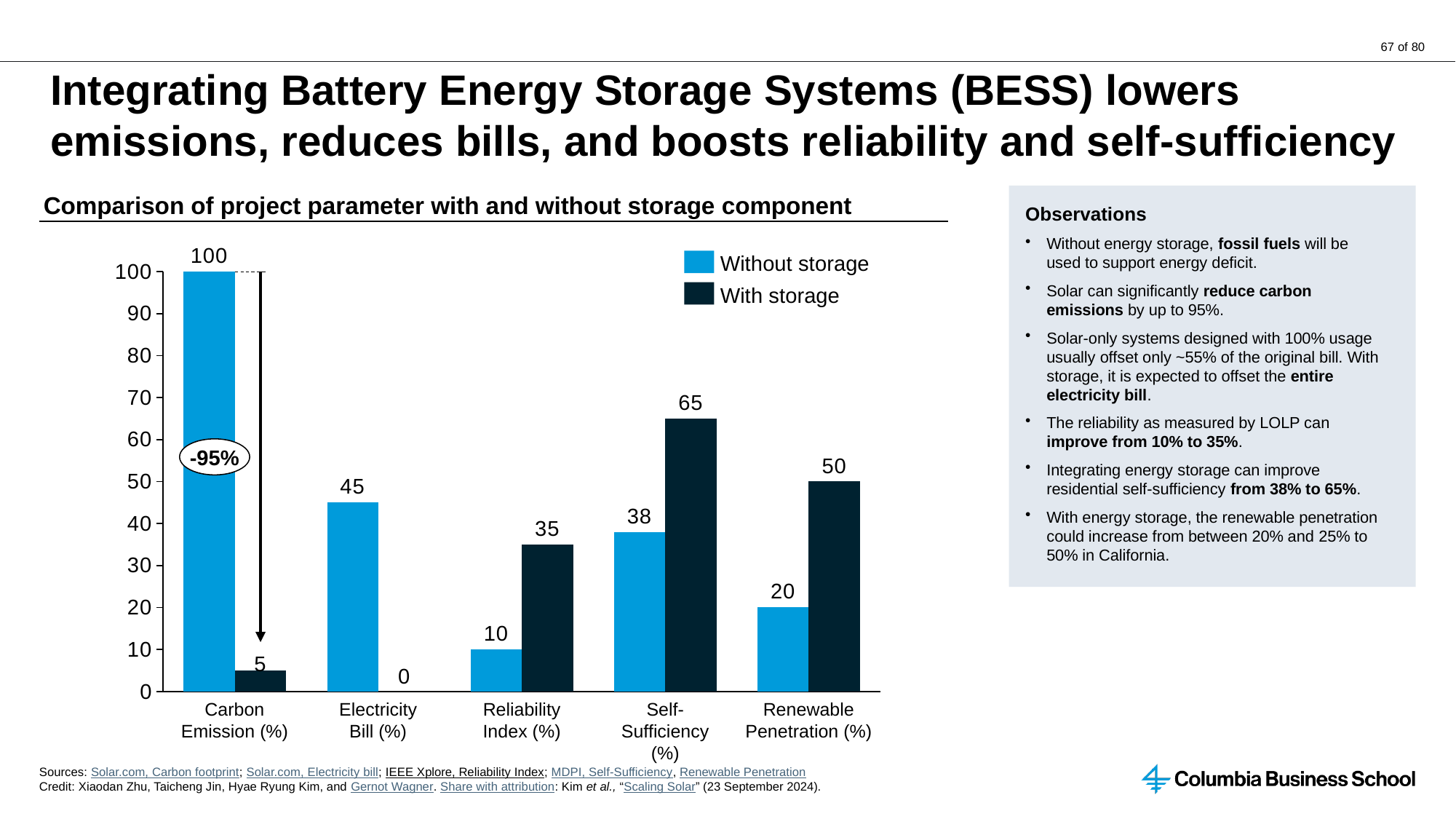
What is the difference between the Without storage and With storage values for Carbon Emission (%)? 95 What percentage change is shown in the oval annotation next to the Carbon Emission bars? -95% What kind of chart is shown on the slide? Bar chart How many categories are shown on the x axis? 5 What is the value for Reliability Index (%) with storage? 35 How many series does the legend list? 2 Which category has the lowest value for the Without storage series? Reliability Index (%) For Renewable Penetration (%), which is larger: the Without storage value or the With storage value? With storage What is the value for Self-Sufficiency (%) without storage? 38 What is the value for Carbon Emission (%) without storage? 100 What is the value for Electricity Bill (%) with storage? 0 Which category has the highest value for the With storage series? Self-Sufficiency (%)